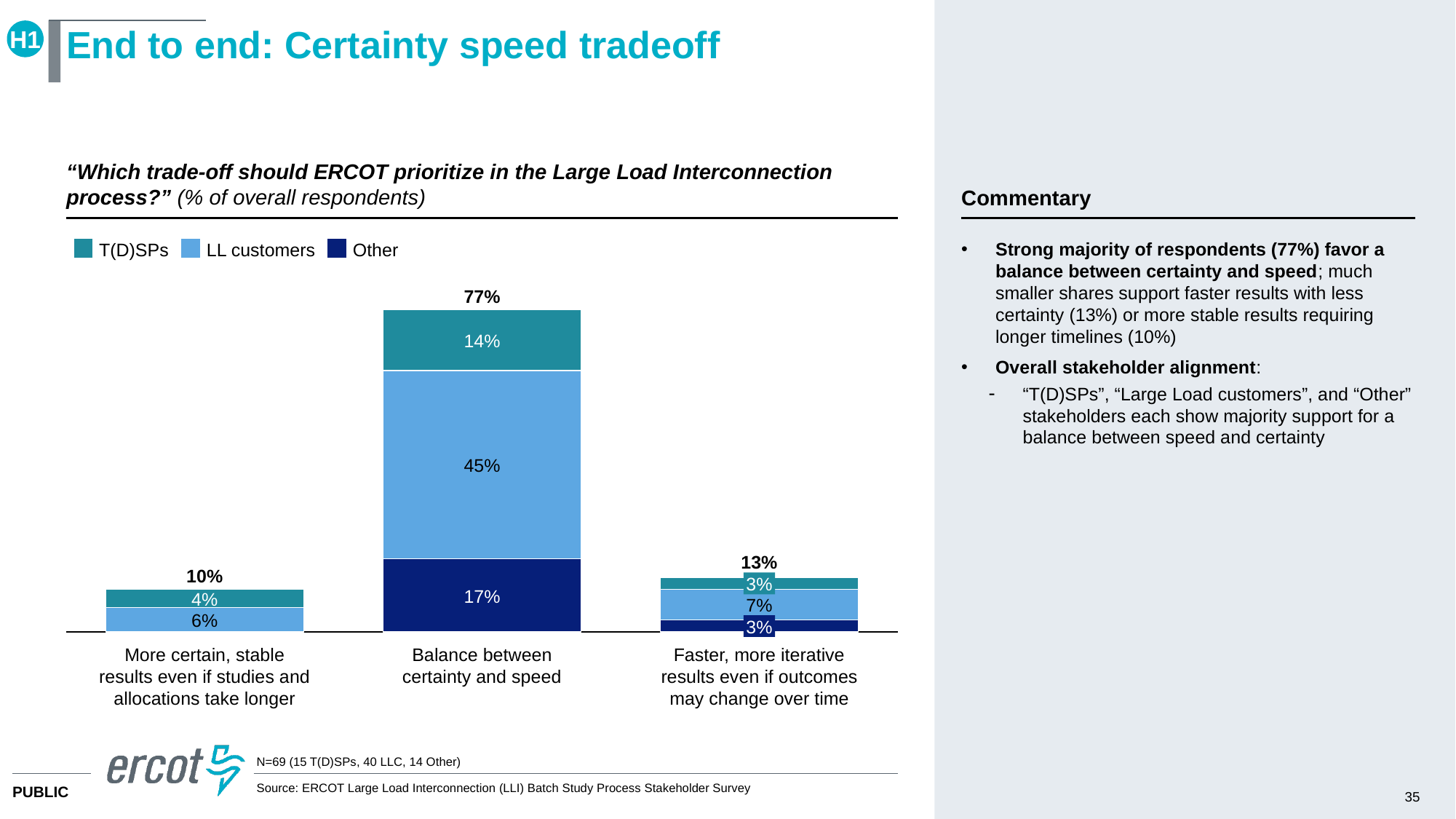
Which is larger: the LL customers value for 'More certain, stable results' or the LL customers value for 'Faster, more iterative results'? Faster, more iterative results even if outcomes may change over time What is the difference between the totals for 'Balance between certainty and speed' and 'Faster, more iterative results even if outcomes may change over time'? 64% What is the total for the 'Balance between certainty and speed' bar? 77% What is the Other value for 'Faster, more iterative results even if outcomes may change over time'? 3% How many series does the legend list? 3 What is the Other value for 'Balance between certainty and speed'? 17% How many categories are shown on the x axis? 3 Which category has the lowest total? More certain, stable results even if studies and allocations take longer What is the T(D)SPs value for 'More certain, stable results even if studies and allocations take longer'? 4% Which category has the highest total? Balance between certainty and speed What is the LL customers value for 'Balance between certainty and speed'? 45% What kind of chart is shown? Stacked bar chart